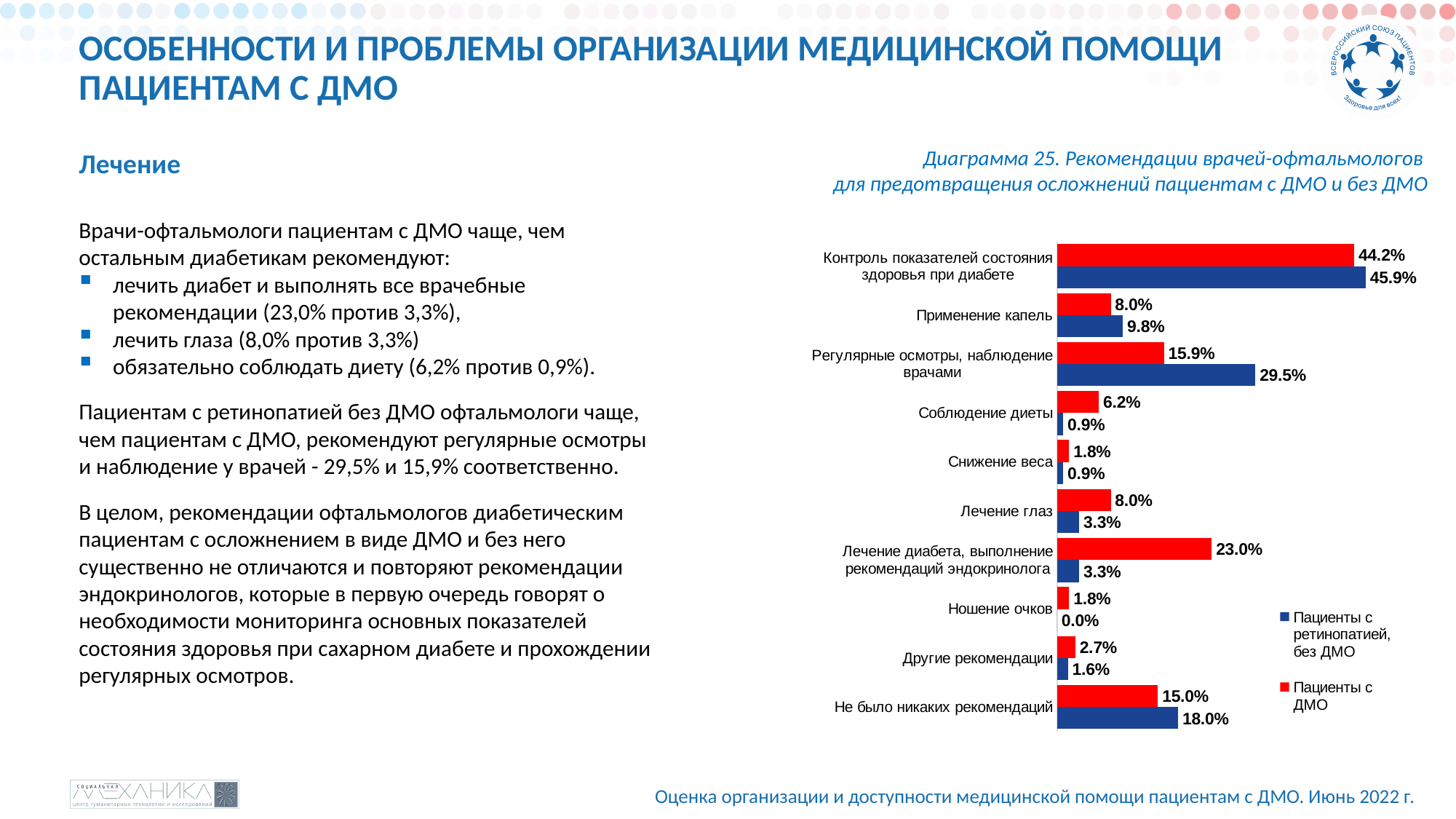
Which category has the lowest value in the "Пациенты с ретинопатией, без ДМО" series? Ношение очков For "Соблюдение диеты", which series has the larger value: "Пациенты с ДМО" or "Пациенты с ретинопатией, без ДМО"? Пациенты с ДМО Which category has the highest value in the "Пациенты с ретинопатией, без ДМО" series? Контроль показателей состояния здоровья при диабете How many series does the chart legend list? 2 What is the value for "Лечение диабета, выполнение рекомендаций эндокринолога" in the "Пациенты с ДМО" series? 23.0% What is the value for "Регулярные осмотры, наблюдение врачами" in the "Пациенты с ретинопатией, без ДМО" series? 29.5% What is the value for "Применение капель" in the "Пациенты с ДМО" series? 8.0% What is the difference between the "Пациенты с ретинопатией, без ДМО" and "Пациенты с ДМО" values for "Регулярные осмотры, наблюдение врачами"? 13.6% What type of chart is shown on the slide? Bar chart Which colour represents the "Пациенты с ДМО" series in the chart? Red What is the difference between the two series' values for "Не было никаких рекомендаций"? 3.0% How many categories are shown on the chart? 10